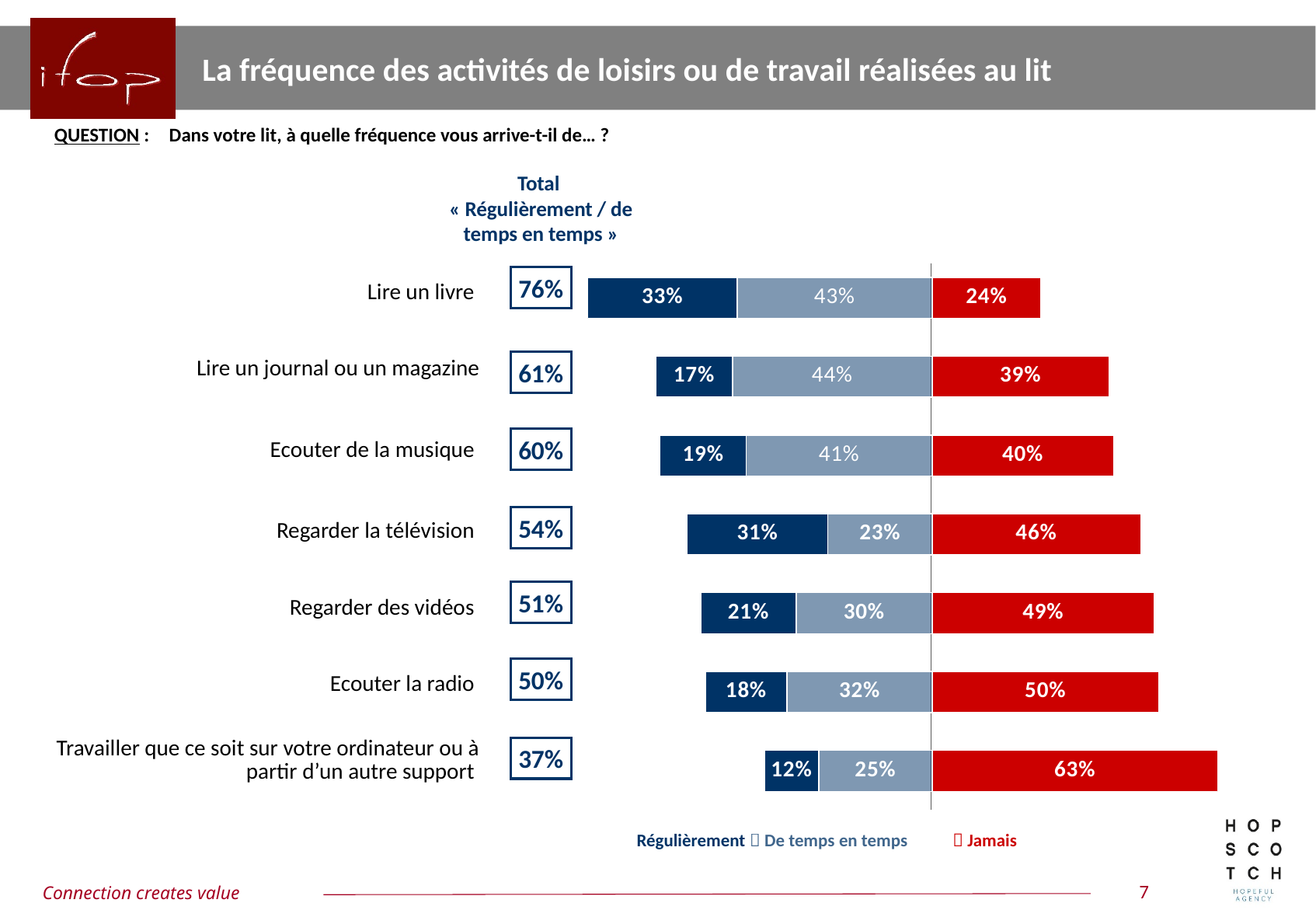
Which colour represents the 'Jamais' series in the chart? Red What is the 'De temps en temps' value for 'Lire un journal ou un magazine'? 44% What is the total 'Régulièrement / de temps en temps' value shown for 'Ecouter de la musique'? 60% What is the 'Régulièrement' value for 'Regarder la télévision'? 31% What kind of chart is shown on the slide? Stacked bar chart What is the difference between the 'Jamais' values for 'Ecouter la radio' and 'Lire un livre'? 26% Which is larger: the 'Régulièrement' value for 'Ecouter de la musique' or for 'Regarder des vidéos'? Regarder des vidéos How many series does the legend list? 3 What percentage of respondents say they 'Jamais' (never) read a book in bed (Lire un livre)? 24% Which activity has the lowest 'Régulièrement' value? Travailler que ce soit sur votre ordinateur ou à partir d'un autre support Which activity has the highest 'Jamais' value? Travailler que ce soit sur votre ordinateur ou à partir d'un autre support How many activities are shown in the chart? 7